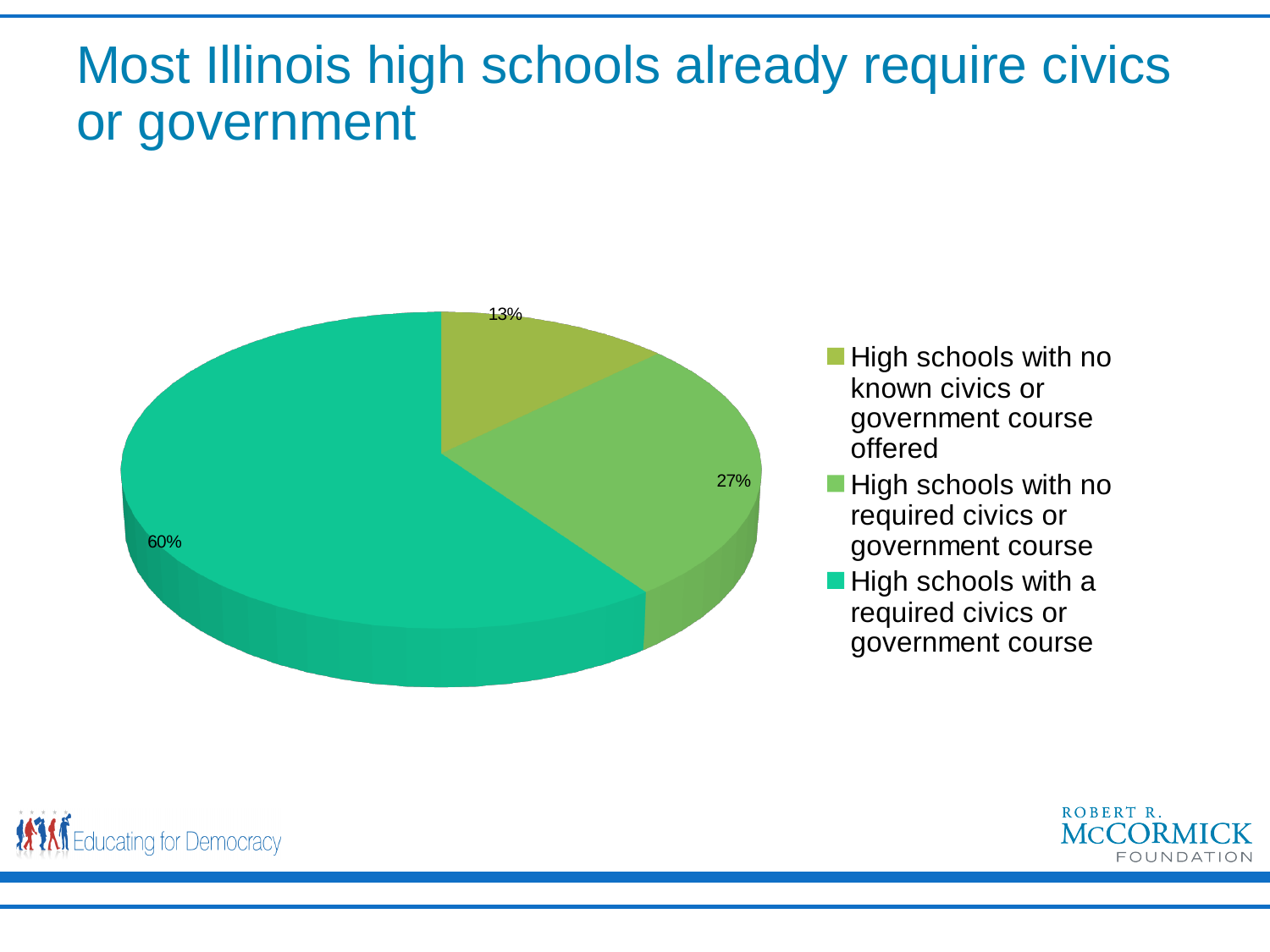
How many entries does the legend list? 3 What share of the pie is for high schools with no required civics or government course? 27% What is the difference in percentage points between the slice for high schools with a required civics or government course and the slice for high schools with no required civics or government course? 33 percentage points What is the combined share of high schools with no known civics or government course offered and high schools with no required civics or government course? 40% Which is larger: the slice for high schools with no required civics or government course or the slice for high schools with no known civics or government course offered? High schools with no required civics or government course What share of the pie is for high schools with no known civics or government course offered? 13% What kind of chart is shown on the slide? Pie chart What is the title of the slide containing the pie chart? Most Illinois high schools already require civics or government Which category has the smallest slice of the pie? High schools with no known civics or government course offered Which category has the largest slice of the pie? High schools with a required civics or government course What share of the pie is for high schools with a required civics or government course? 60% How many slices does the pie chart have? 3